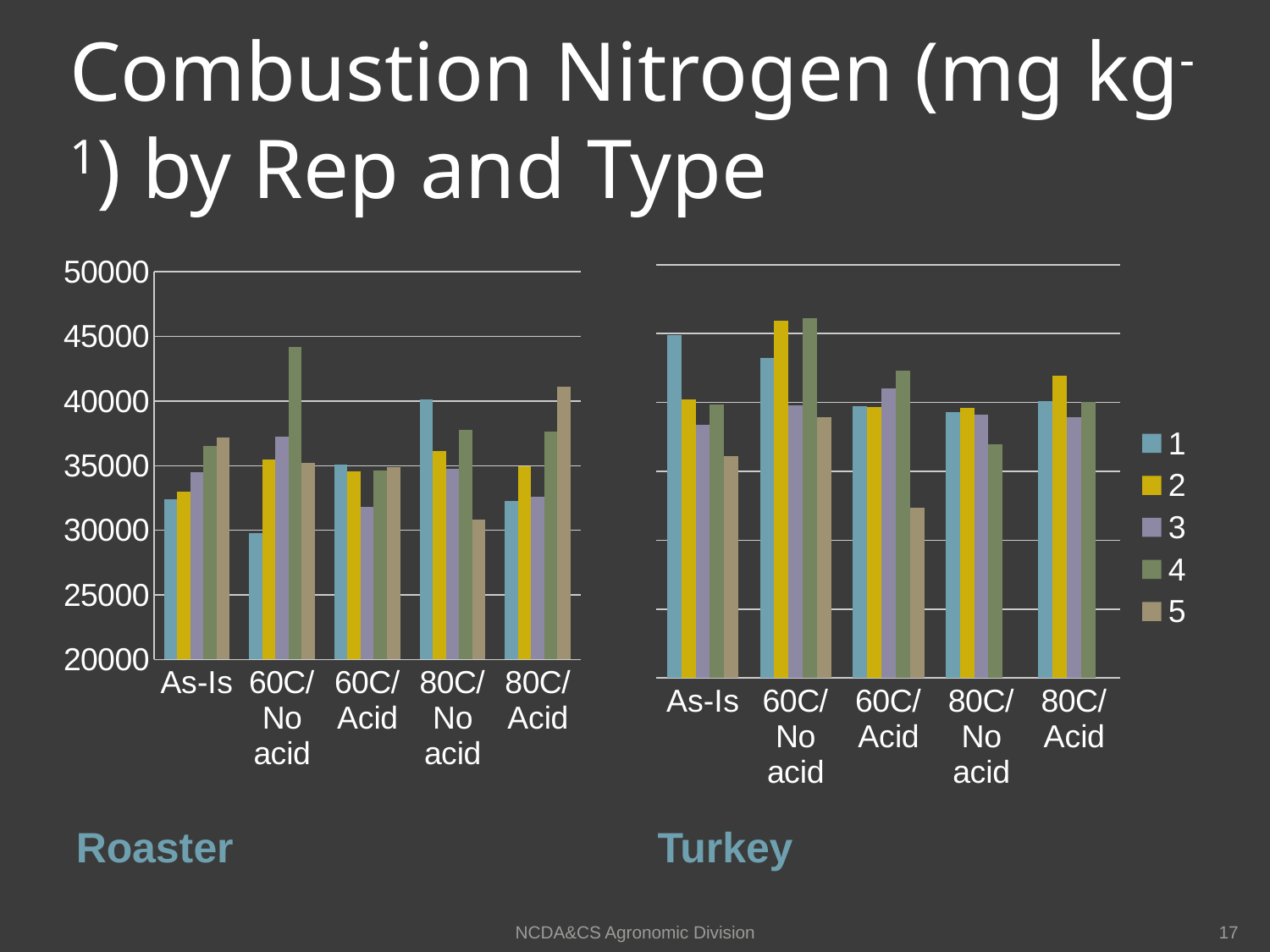
How many series does the legend list for the charts? 5 How many categories are shown on the x axis of the Turkey chart? 5 In the Turkey chart, which series has the lowest value at 60C/Acid? 5 In the Roaster chart, is the value for series 5 at 80C/No acid greater or less than 35000? less In the Turkey chart, which series has the highest value at As-Is? 1 What kind of chart is the Roaster chart on the left? bar chart In the Roaster chart, which series has the lowest value at 60C/No acid? 1 In the Roaster chart, which series has the highest value at 60C/No acid? 4 In the Roaster chart, is the value for series 4 at 60C/No acid greater or less than 40000? greater In the Roaster chart, at As-Is, which is larger: series 1 or series 5? 5 What label appears below the chart on the right side of the slide? Turkey In the Roaster chart, is the value for series 1 at 80C/No acid greater or less than 35000? greater